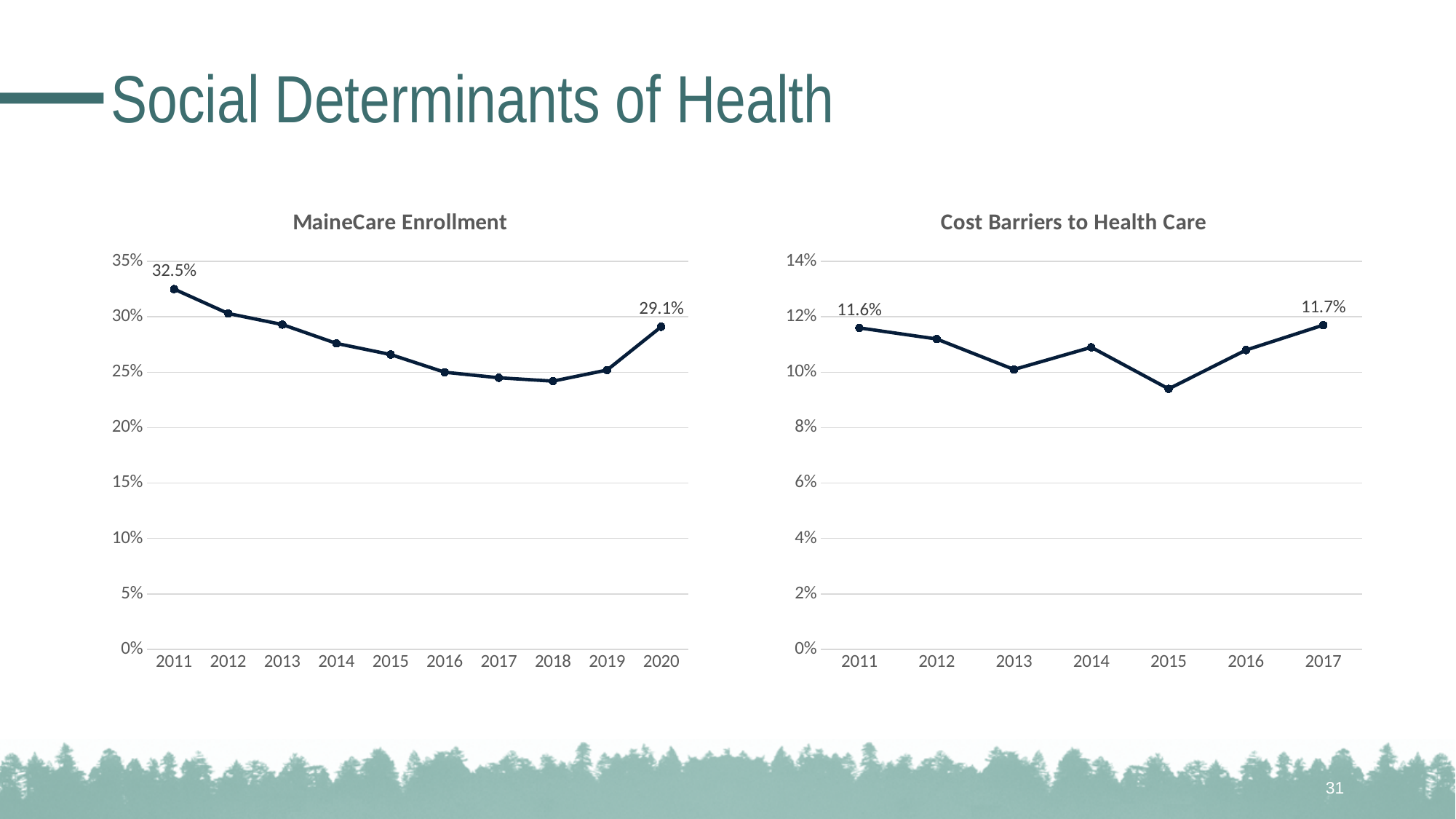
In the Cost Barriers to Health Care chart, what is the value for 2011? 11.6% In the MaineCare Enrollment chart, what is the value for 2020? 29.1% In the MaineCare Enrollment chart, is the value for 2018 greater or less than 25%? less In the MaineCare Enrollment chart, what is the value for 2011? 32.5% What kind of chart is the MaineCare Enrollment chart? Line chart In the MaineCare Enrollment chart, what is the difference between the 2011 and 2020 values? 3.4% In the Cost Barriers to Health Care chart, which year has the lowest value? 2015 In the Cost Barriers to Health Care chart, what is the value for 2017? 11.7% In the MaineCare Enrollment chart, which year has the highest value? 2011 How many years are plotted in the Cost Barriers to Health Care chart? 7 How many years are plotted in the MaineCare Enrollment chart? 10 In the Cost Barriers to Health Care chart, is the value for 2015 greater or less than 10%? less